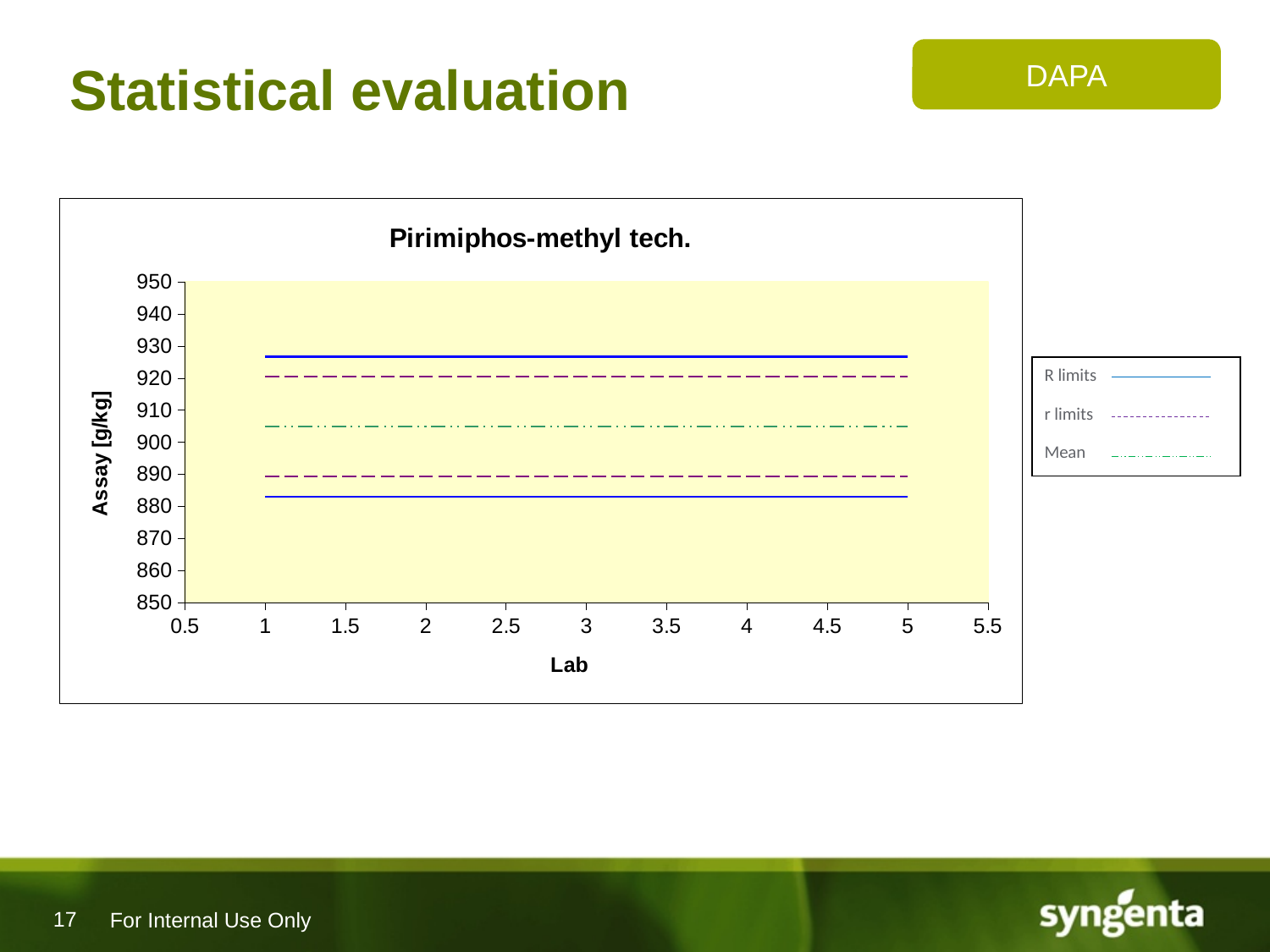
Is the value of the Mean line greater or less than 910? less Is the lower R limits line greater or less than 880? greater What kind of chart is shown on the slide? line chart Is the lower R limits line greater or less than 890? less What is the title of the chart? Pirimiphos-methyl tech. Do the plotted lines rise, fall, or stay constant as Lab increases along the x axis? stay constant Which series has the highest line on the chart? R limits How many series does the chart legend list? 3 What is the label of the y axis? Assay [g/kg]